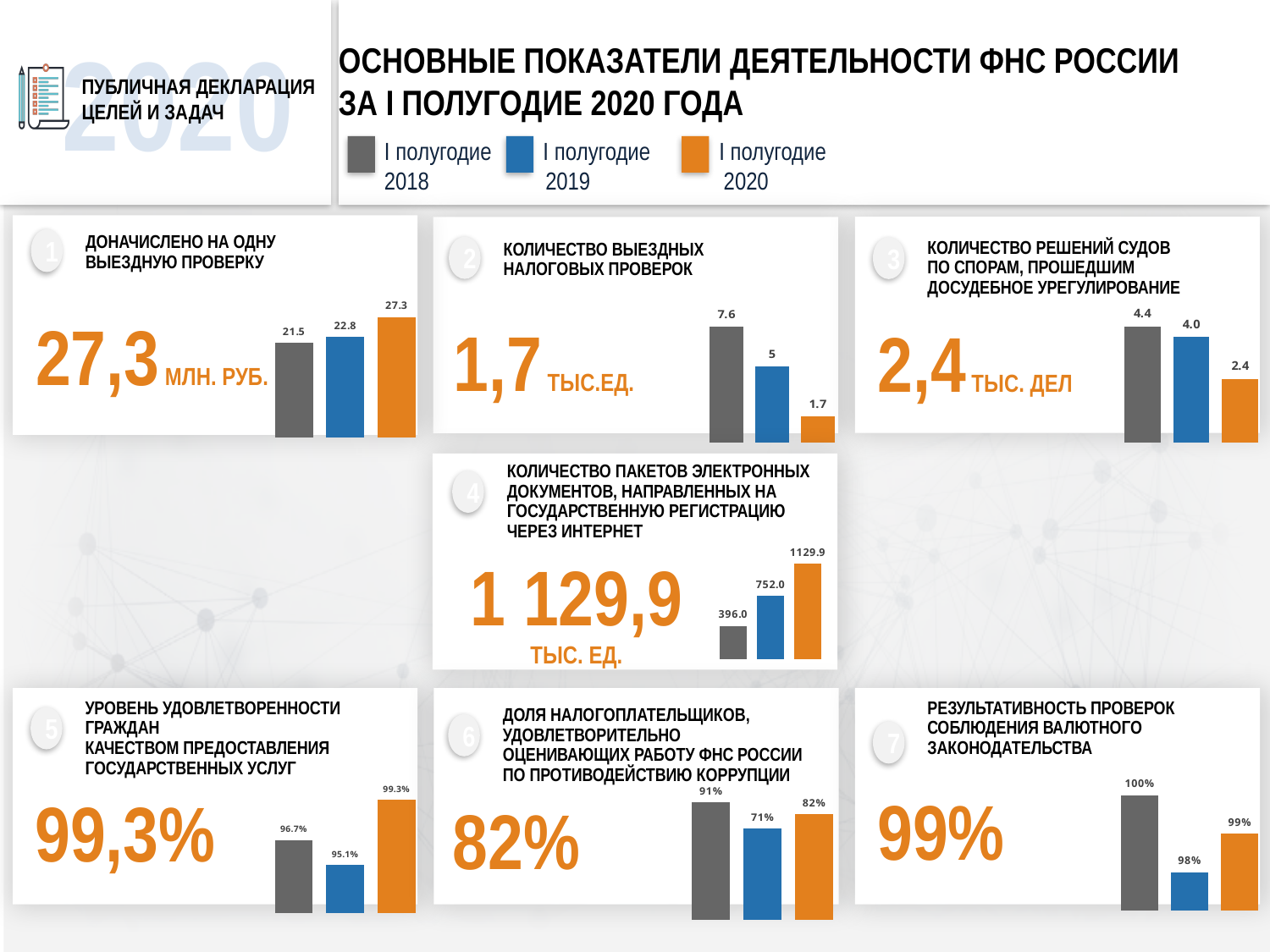
In the chart 'Результативность проверок соблюдения валютного законодательства', what is the value for I полугодие 2018? 100% In the chart 'Количество решений судов по спорам, прошедшим досудебное урегулирование', what is the difference between the 2018 and 2020 values? 2.0 In the chart 'Доля налогоплательщиков, удовлетворительно оценивающих работу ФНС России по противодействию коррупции', what is the value for I полугодие 2019? 71% In the chart 'Количество пакетов электронных документов, направленных на государственную регистрацию через интернет', do the values rise or fall from 2018 to 2020? rise How many bars are in the chart 'Доначислено на одну выездную проверку'? 3 What type of chart is used in the panel 'Количество выездных налоговых проверок'? bar chart In the chart 'Количество пакетов электронных документов, направленных на государственную регистрацию через интернет', what is the value for I полугодие 2019? 752.0 In the chart 'Доначислено на одну выездную проверку', what is the value for I полугодие 2020? 27.3 In the chart 'Количество выездных налоговых проверок', which period has the lowest value? I полугодие 2020 In the chart 'Доля налогоплательщиков, удовлетворительно оценивающих работу ФНС России по противодействию коррупции', which is larger: the 2018 value or the 2020 value? 2018 In the chart 'Количество выездных налоговых проверок', what is the value for I полугодие 2018? 7.6 In the chart 'Уровень удовлетворенности граждан качеством предоставления государственных услуг', which period has the highest value? I полугодие 2020